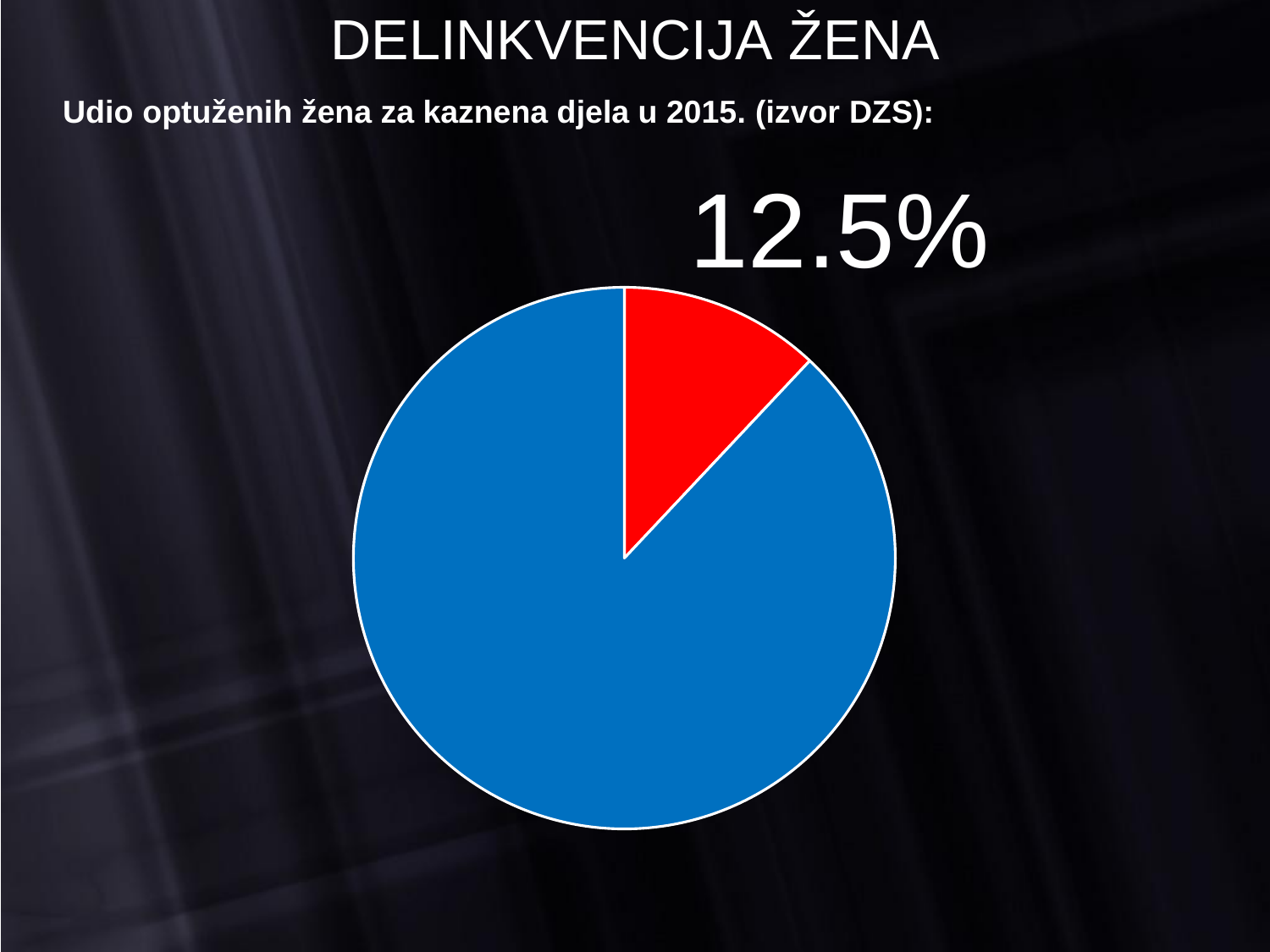
What year does the chart's caption say the data refers to? 2015 What share of the pie does the red slice represent? 12.5% Is the blue slice's share of the pie greater or less than 50%? greater What share of the pie does the blue slice represent, given the red slice is 12.5%? 87.5% How many slices does the pie chart have? 2 Which slice of the pie is larger, the red one or the blue one? blue What kind of chart is shown on the slide? pie chart Which slice of the pie is the smallest? the red slice What colour is the slice labelled 12.5%? red